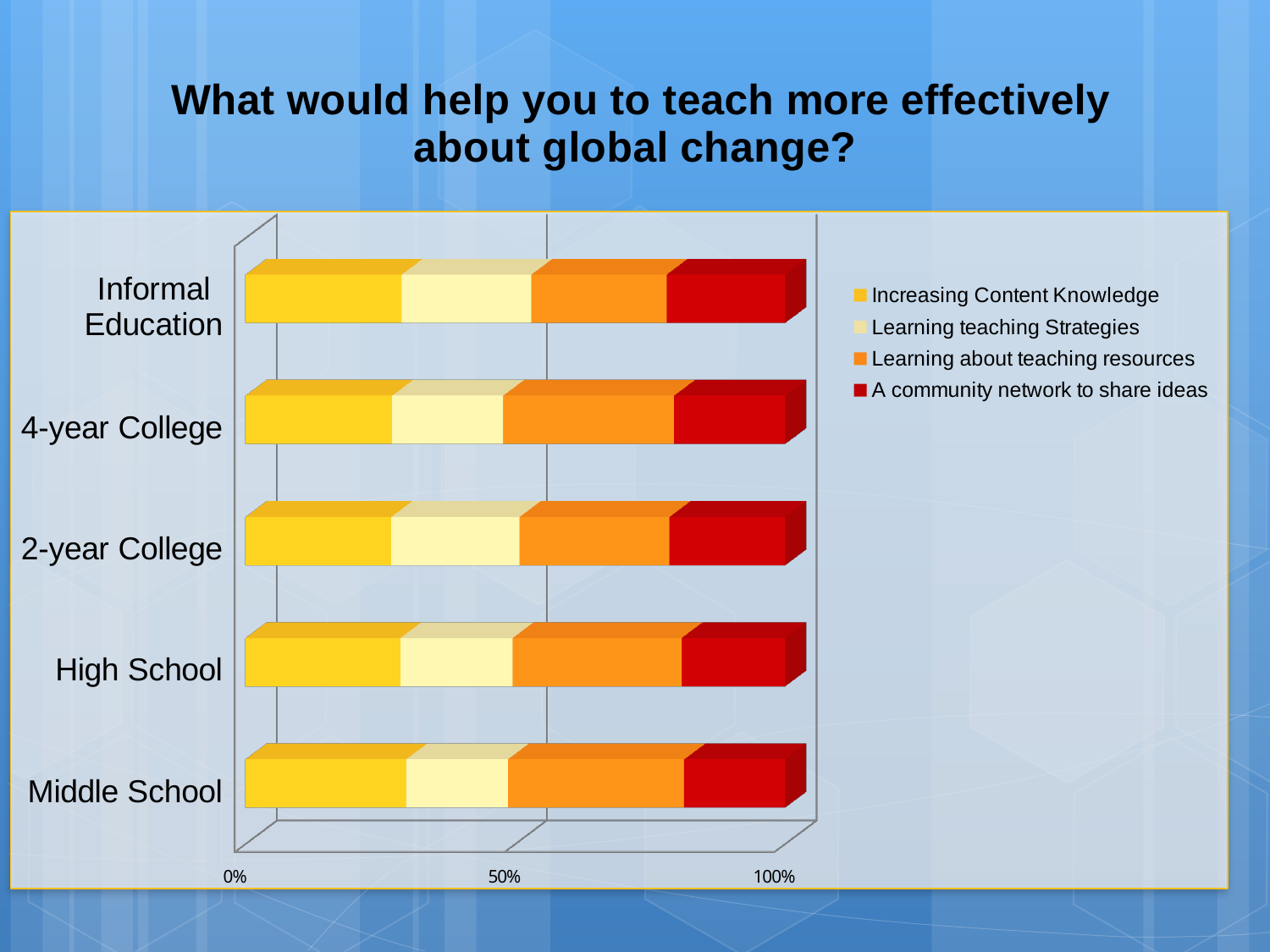
Is the value for Increasing Content Knowledge in Middle School greater or less than 50%? less Which legend entry is shown in dark red? A community network to share ideas How many series does the chart's legend list? 4 In the Middle School bar, which is larger: Increasing Content Knowledge or Learning teaching Strategies? Increasing Content Knowledge In the 2-year College bar, which is larger: Increasing Content Knowledge or Learning teaching Strategies? Increasing Content Knowledge What kind of chart is shown on the slide? Stacked bar chart Which category is listed at the bottom of the chart's vertical axis? Middle School What is the title of the slide containing the chart? What would help you to teach more effectively about global change? Is the value for Increasing Content Knowledge in 4-year College greater or less than 50%? less Is the value for Increasing Content Knowledge in Informal Education greater or less than 50%? less How many categories are shown on the vertical axis of the chart? 5 In the High School bar, which is larger: Learning about teaching resources or Learning teaching Strategies? Learning about teaching resources